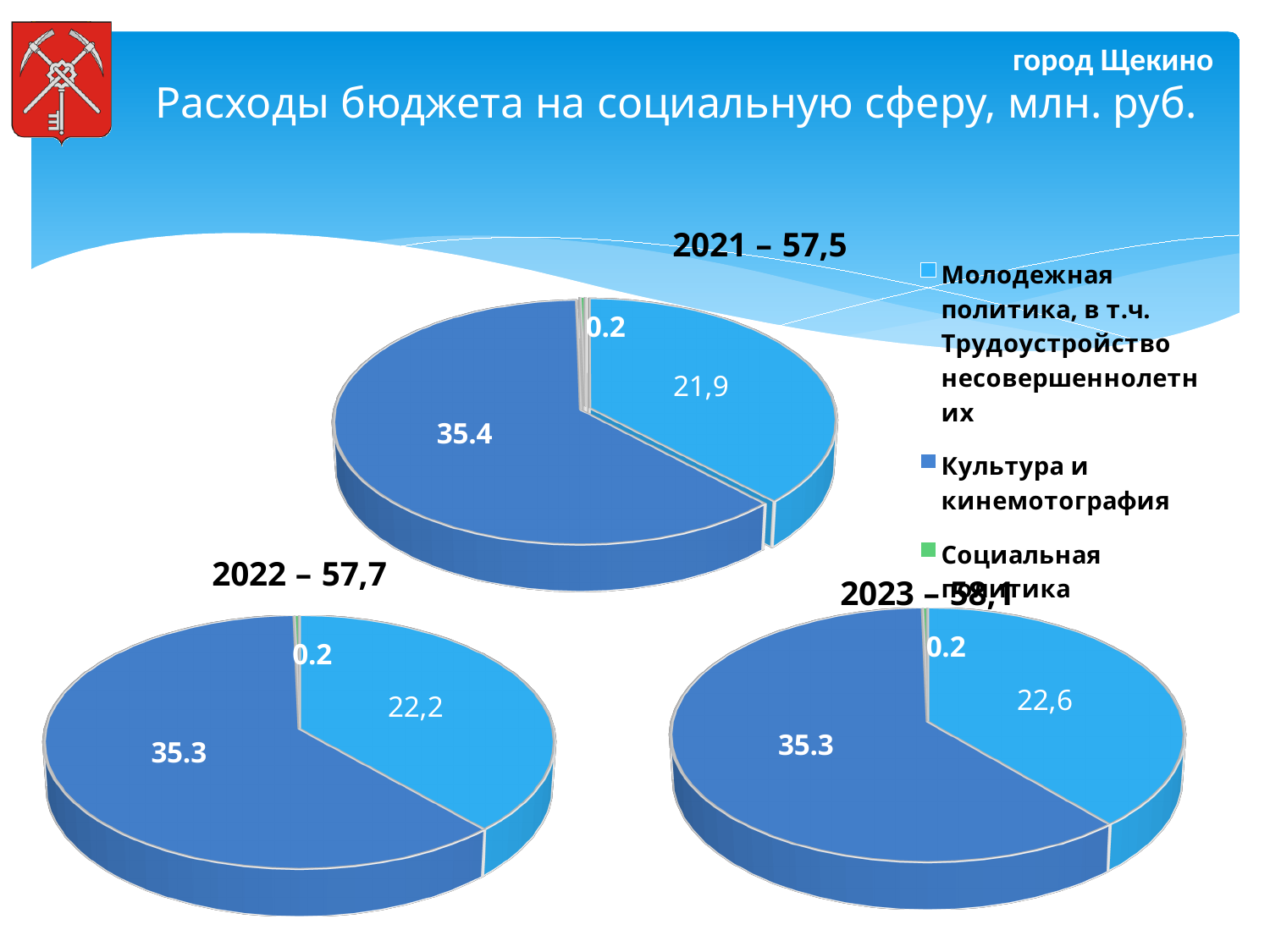
In the 2023 – 58,1 pie chart, what is the value for Молодежная политика, в т.ч. Трудоустройство несовершеннолетних? 22,6 In the 2021 – 57,5 pie chart, what is the value for Культура и кинемотография? 35.4 In the 2022 – 57,7 pie chart, what is the value for Социальная политика? 0.2 In the 2023 – 58,1 pie chart, which is larger: Культура и кинемотография or Молодежная политика? Культура и кинемотография In the 2021 – 57,5 pie chart, which category has the smallest slice? Социальная политика In the 2022 – 57,7 pie chart, what is the value for Молодежная политика, в т.ч. Трудоустройство несовершеннолетних? 22,2 In the 2023 – 58,1 pie chart, which category has the largest slice? Культура и кинемотография How many categories does the legend list? 3 In the 2021 – 57,5 pie chart, what is the value for Молодежная политика, в т.ч. Трудоустройство несовершеннолетних? 21,9 What type of chart is used on this slide? Pie chart In the 2022 – 57,7 pie chart, what is the difference between the values for Культура и кинемотография and Молодежная политика? 13.1 How many pie charts are shown on the slide? 3